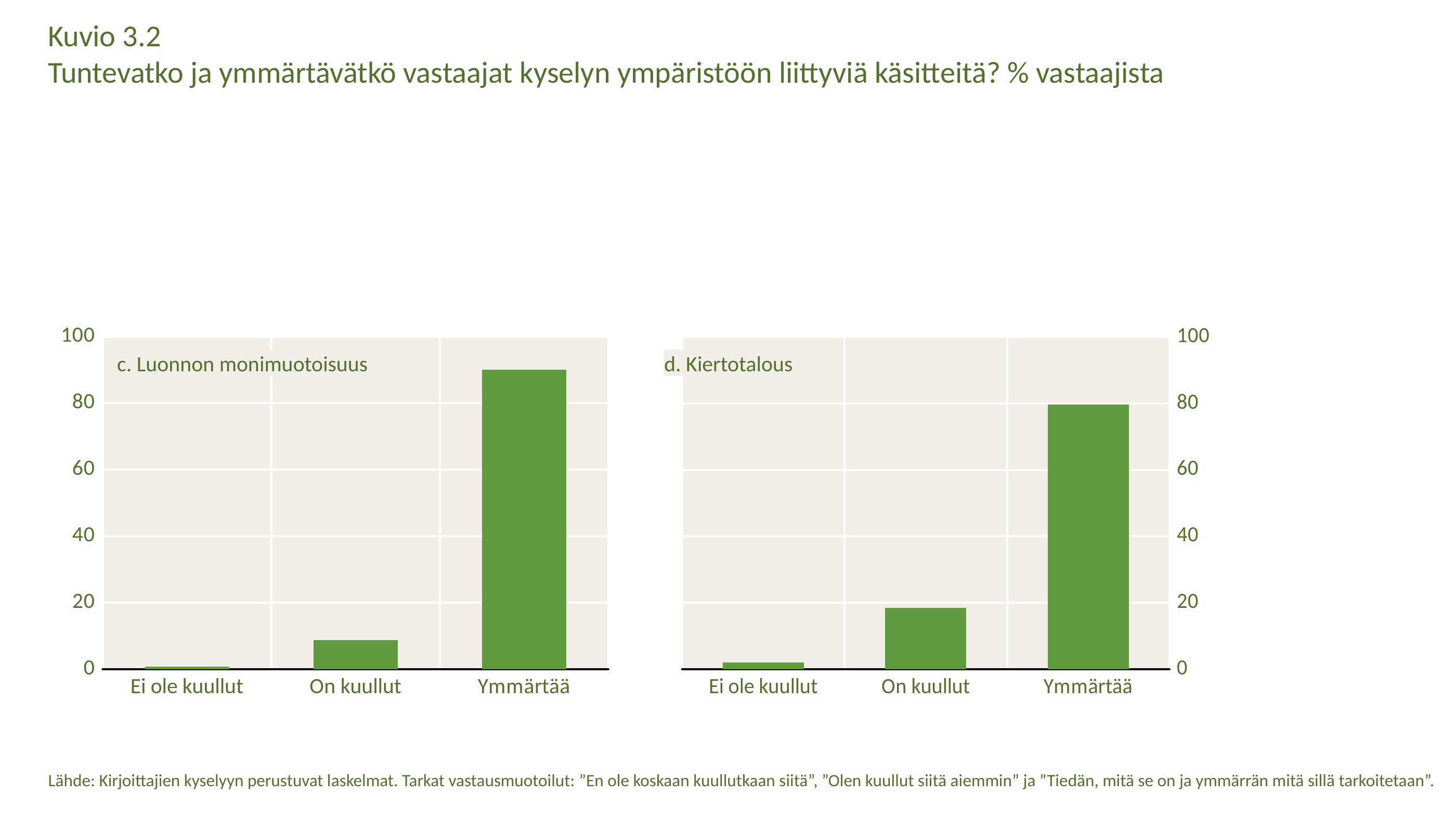
Which is larger: On kuullut in the "c. Luonnon monimuotoisuus" chart or On kuullut in the "d. Kiertotalous" chart? On kuullut in d. Kiertotalous What kind of chart is "c. Luonnon monimuotoisuus"? bar chart What is the figure number given in the slide title? Kuvio 3.2 In the "c. Luonnon monimuotoisuus" chart, which category has the highest value? Ymmärtää In the "d. Kiertotalous" chart, which category has the highest value? Ymmärtää In the "d. Kiertotalous" chart, do the values rise or fall from Ei ole kuullut to Ymmärtää? rise In the "c. Luonnon monimuotoisuus" chart, is the value for Ymmärtää greater or less than 80? greater How many categories are shown on the x axis of the "d. Kiertotalous" chart? 3 In the "d. Kiertotalous" chart, is the value for On kuullut greater or less than 20? less In the "c. Luonnon monimuotoisuus" chart, which category has the lowest value? Ei ole kuullut In the "d. Kiertotalous" chart, which category has the lowest value? Ei ole kuullut